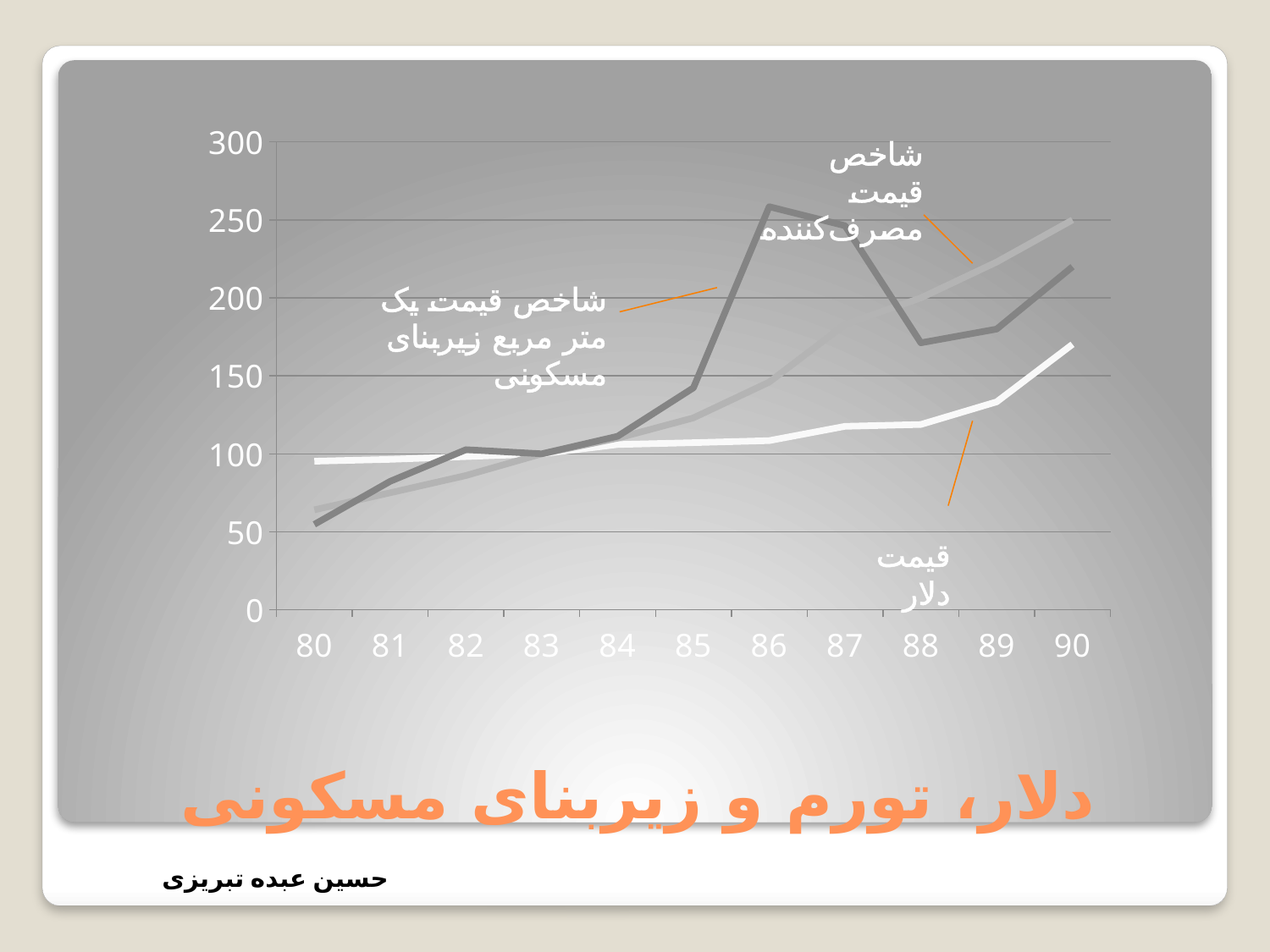
In which year does the housing price index per square meter (شاخص قیمت یک متر مربع زیربنای مسکونی) line reach its highest point? 86 How many data series (lines) are plotted on the chart? 3 Is the value of the housing price index per square meter line in year 80 greater or less than 100? less Is the value of the dollar price (قیمت دلار) line in year 85 greater or less than 150? less How many years are marked along the x axis of the chart? 11 In year 86, which line is higher: the housing price index per square meter or the consumer price index (شاخص قیمت مصرف‌کننده)? housing price index per square meter Is the value of the housing price index per square meter line in year 86 greater or less than 200? greater What is the title written at the bottom of the slide? دلار، تورم و زیربنای مسکونی What kind of chart is shown on the slide? line chart In year 90, which line is higher: the consumer price index (شاخص قیمت مصرف‌کننده) or the dollar price (قیمت دلار)? consumer price index In which year is the housing price index per square meter (شاخص قیمت یک متر مربع زیربنای مسکونی) line at its lowest point? 80